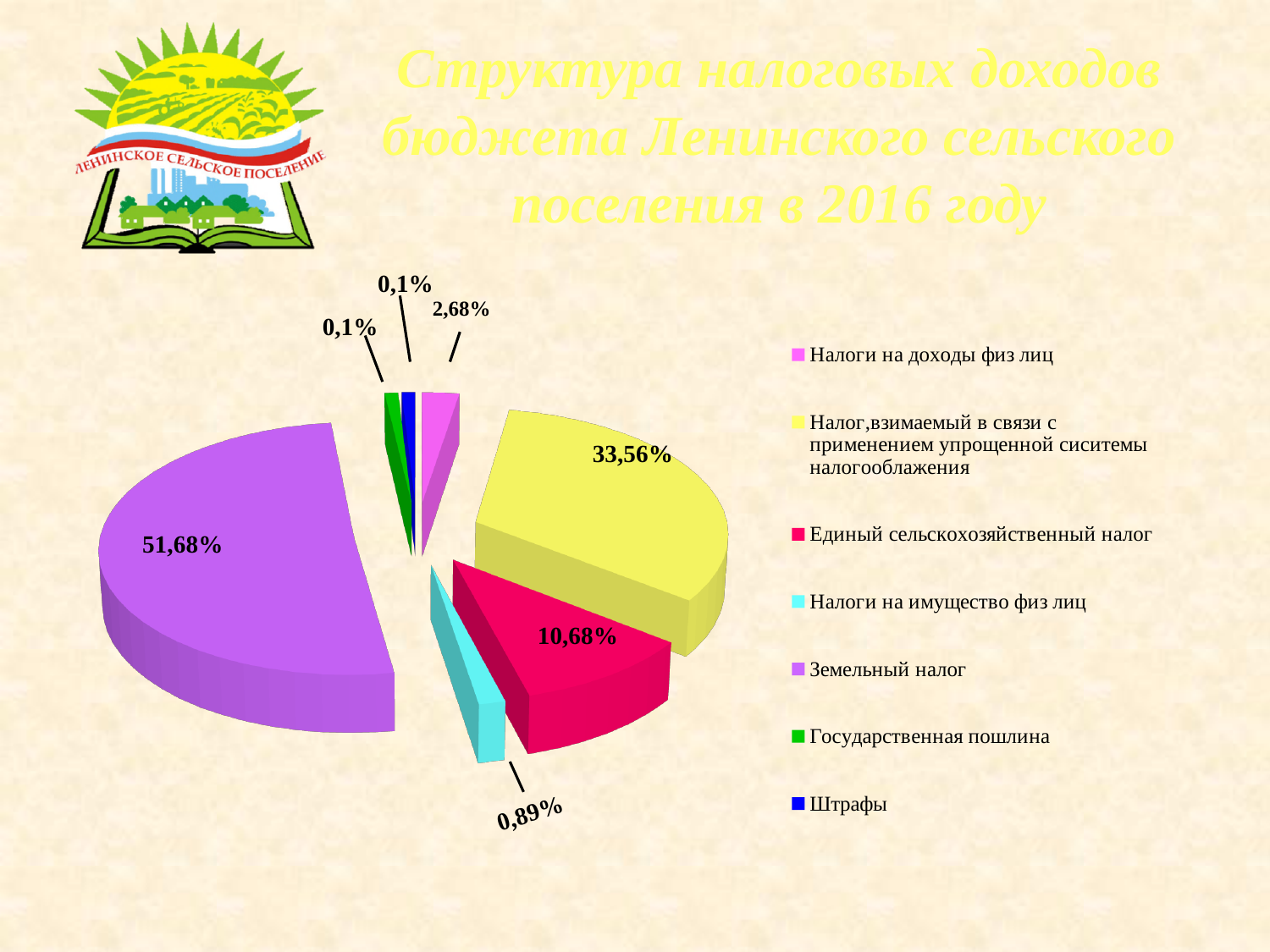
What is the difference between the shares of Земельный налог and Налог, взимаемый в связи с применением упрощенной системы налогообложения? 18,12% Which category has the largest share of the pie? Земельный налог How many categories does the legend list? 7 What kind of chart is shown on the slide? Pie chart What share of tax revenues does Земельный налог account for? 51,68% What is the value shown for Штрафы? 0,1% What colour is the slice for Единый сельскохозяйственный налог? Red What is the value shown for Налоги на доходы физ лиц? 2,68% What is the value shown for Единый сельскохозяйственный налог? 10,68% Which is larger: Единый сельскохозяйственный налог or Налоги на доходы физ лиц? Единый сельскохозяйственный налог What is the value shown for Налог, взимаемый в связи с применением упрощенной системы налогообложения? 33,56% What is the value shown for Налоги на имущество физ лиц? 0,89%